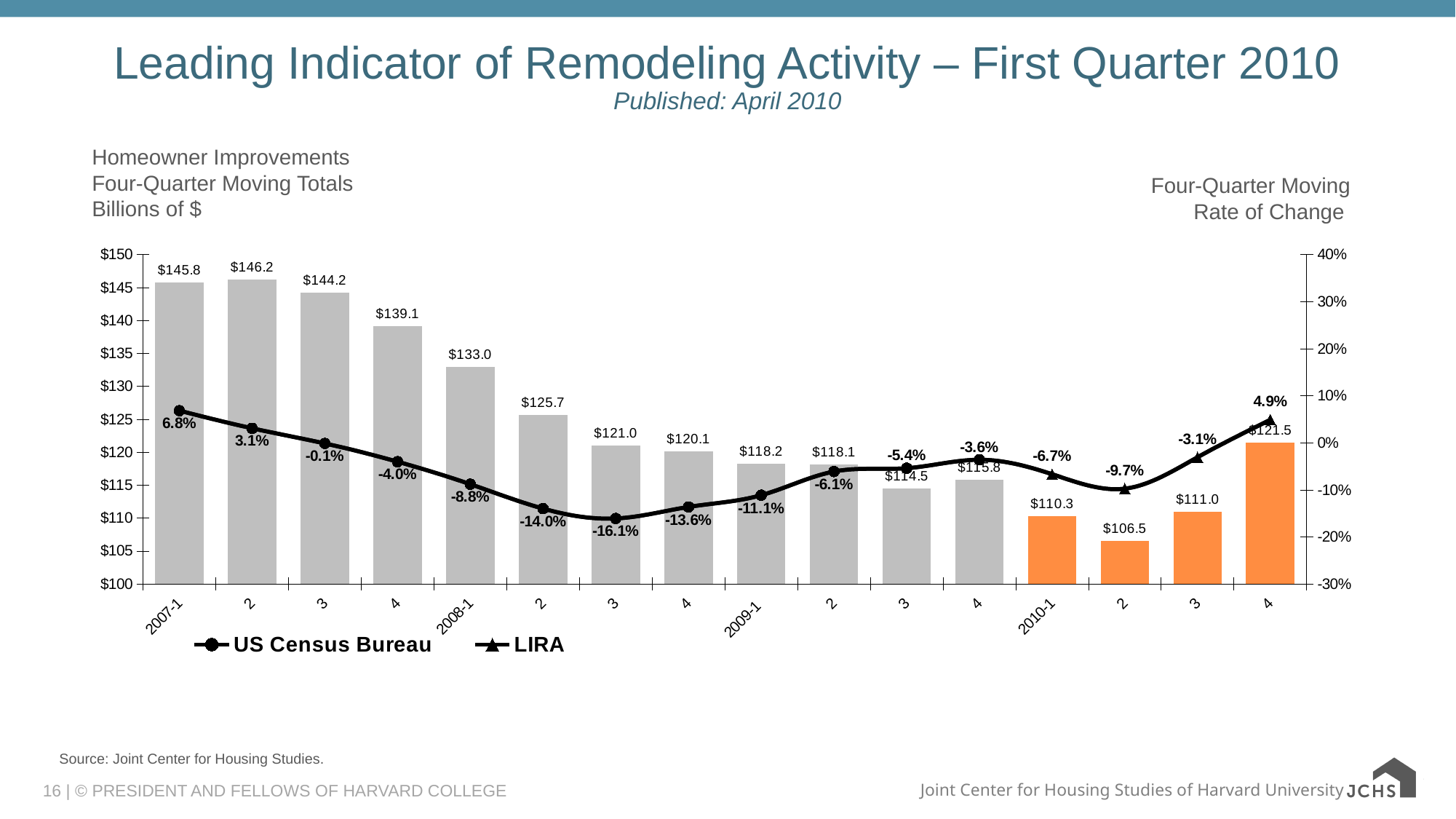
What is the four-quarter moving total of homeowner improvements for 2007-1? $145.8 What is the four-quarter moving rate of change shown for 2008-3? -16.1% How many series does the legend list? 2 What is the difference between the four-quarter moving totals for 2007-1 and 2010-4? $24.3 Which quarter has the lowest four-quarter moving total (bar)? 2010-2 Which quarter has the lowest four-quarter moving rate of change on the line? 2008-3 How many quarters (bars) are plotted on the chart? 16 What kind of chart is shown on the slide? Combination bar and line chart What is the rate of change shown for the last quarter, 2010-4? 4.9% Which has the larger four-quarter moving total, 2009-3 or 2009-4? 2009-4 Which quarter has the highest four-quarter moving total (bar)? 2007-2 Do the four-quarter moving totals rise or fall from 2007-1 to 2010-2? Fall